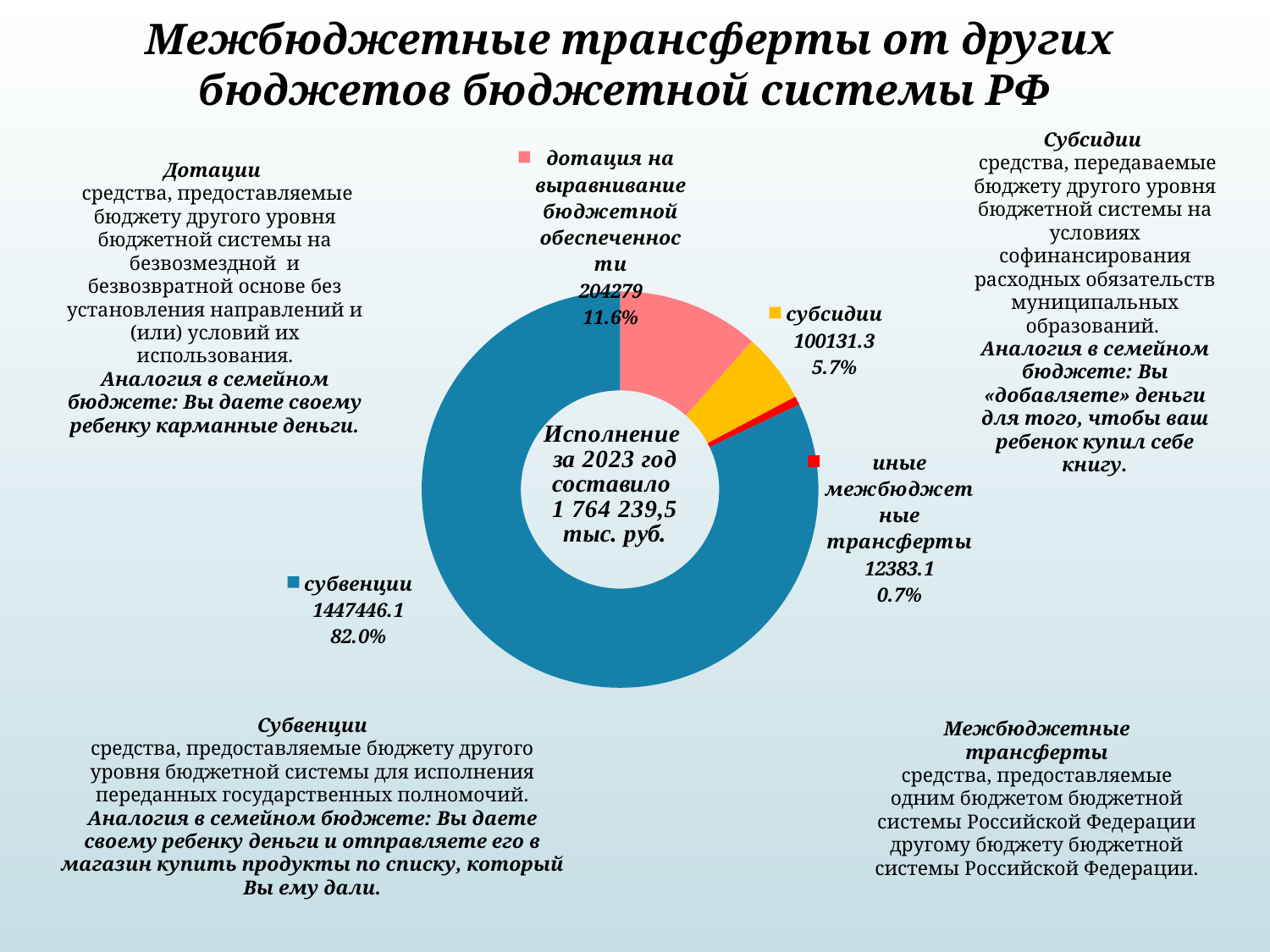
What share of the chart does дотация на выравнивание бюджетной обеспеченности represent? 11.6% What is the value for дотация на выравнивание бюджетной обеспеченности in the chart? 204279 What is the value for иные межбюджетные трансферты in the chart? 12383.1 What is the value for субсидии in the chart? 100131.3 What is the difference between the values for дотация на выравнивание бюджетной обеспеченности and субсидии? 104147.7 How many categories does the doughnut chart show? 4 What share of the chart does субсидии represent? 5.7% What kind of chart is shown on the slide? Doughnut (pie) chart Which category has the largest share of the doughnut chart? субвенции According to the text in the centre of the chart, what was the total execution for 2023? 1 764 239,5 тыс. руб. Which category has the smallest share of the doughnut chart? иные межбюджетные трансферты What is the value for субвенции in the chart? 1447446.1